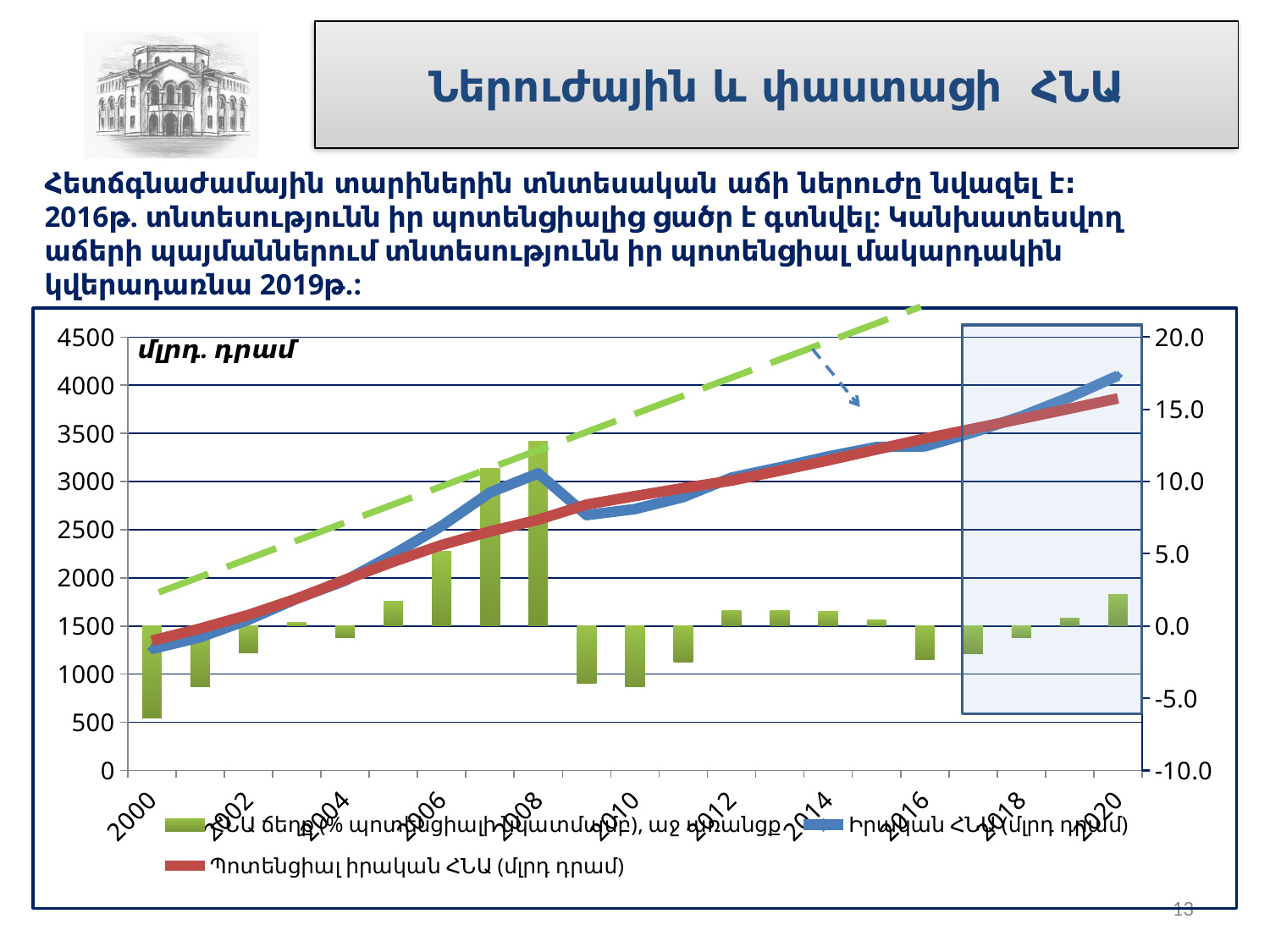
Is the green bar value for 2008 greater or less than 10.0 on the right axis? greater Is the blue line (Իրական ՀՆԱ) value for 2020 greater or less than 3500 on the left axis? greater What kind of chart is shown on the slide? A combined bar and line chart In which year is the green bar (ՀՆԱ ճեղք) the highest? 2008 Does the red line (Պոտենցիալ իրական ՀՆԱ) rise or fall from 2000 to 2020? rises Which is larger: the green bar for 2008 or the green bar for 2009? 2008 Is the green bar value for 2000 greater or less than -5.0 on the right axis? less How many years are plotted along the x axis of the chart (2000 to 2020)? 21 In which year is the green bar (ՀՆԱ ճեղք) the lowest? 2000 How many series does the chart legend list? 3 What unit label is printed at the top left of the chart's plot area? մլրդ. դրամ